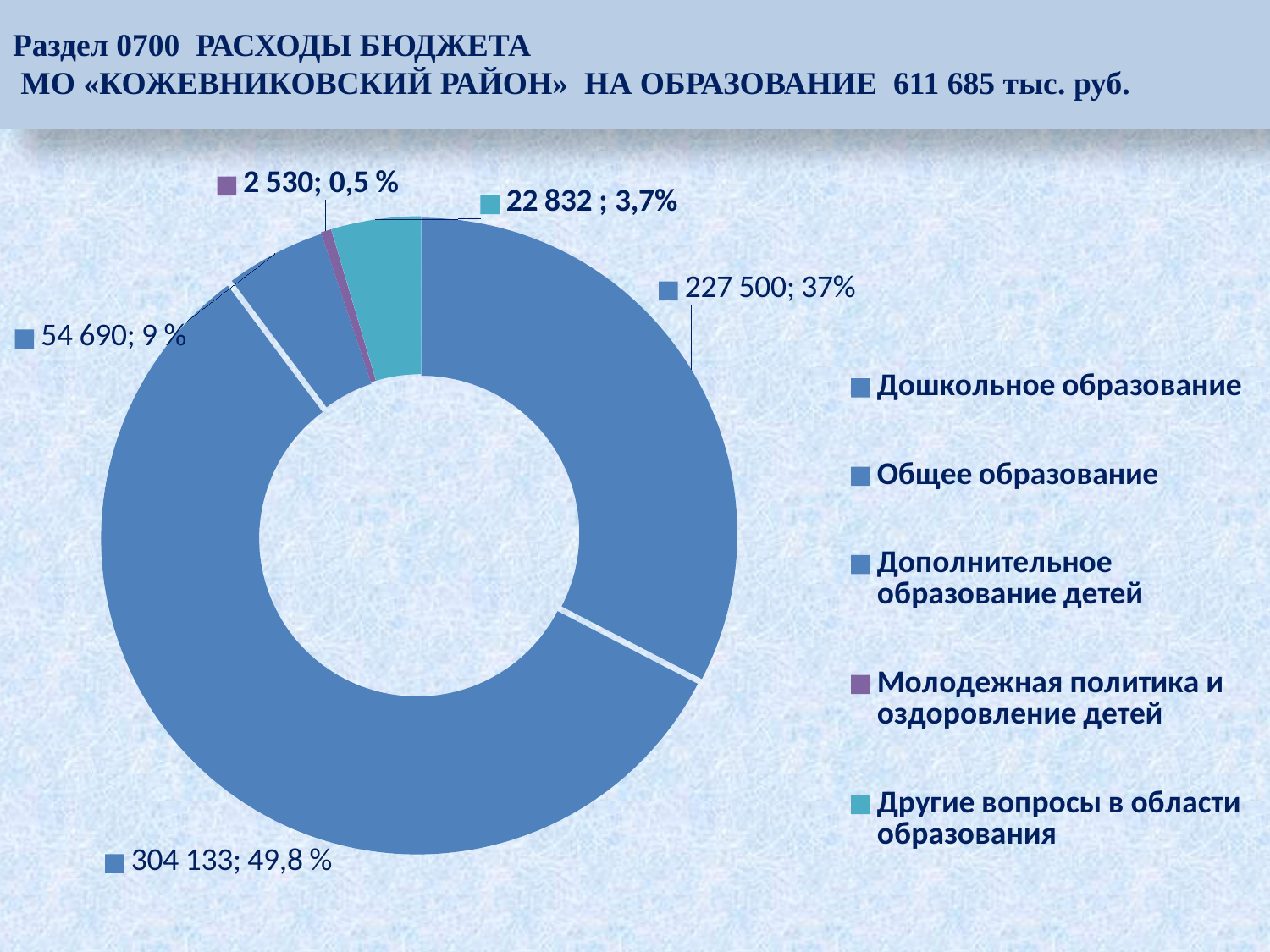
How many slices does the chart have? 5 What is the difference between the slice labelled 304 133 and the slice labelled 227 500? 76 633 What value and share are shown for the teal slice (Другие вопросы в области образования)? 22 832 ; 3,7% What is the value of the largest slice in the chart? 304 133 What kind of chart is shown on the slide? Doughnut (pie) chart What share is shown for the slice labelled 227 500? 37% What is the value of the smallest slice in the chart? 2 530 What share of the chart does the largest slice represent? 49,8 % What total amount in thousand rubles is stated in the slide title for education expenditure? 611 685 тыс. руб. Which is larger: the slice labelled 54 690 or the slice labelled 22 832? 54 690 What value and share are shown for the purple slice (Молодежная политика и оздоровление детей)? 2 530; 0,5 % How many entries does the legend list? 5